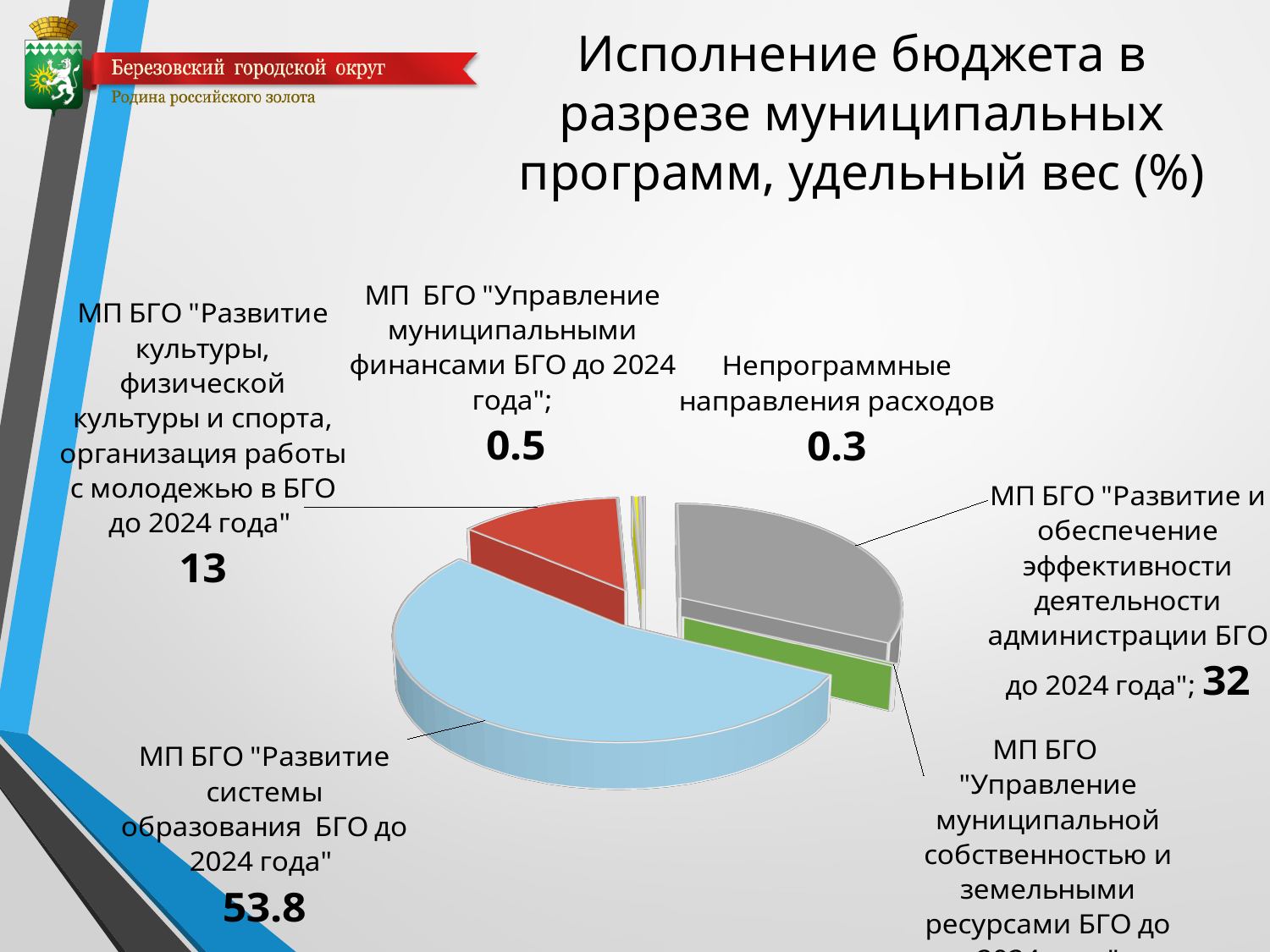
Which is larger: the value for МП БГО "Развитие культуры, физической культуры и спорта..." or the value for МП БГО "Управление муниципальными финансами БГО до 2024 года"? МП БГО "Развитие культуры, физической культуры и спорта..." What type of chart is shown on the slide? pie chart Which of the labelled categories has the smallest printed value? Непрограммные направления расходов What is the title of the chart on the slide? Исполнение бюджета в разрезе муниципальных программ, удельный вес (%) What is the value for МП БГО "Развитие системы образования БГО до 2024 года"? 53.8 What is the value for МП БГО "Управление муниципальными финансами БГО до 2024 года"? 0.5 What is the difference between the values for МП БГО "Развитие системы образования БГО до 2024 года" and МП БГО "Развитие и обеспечение эффективности деятельности администрации БГО до 2024 года"? 21.8 What is the value for МП БГО "Развитие и обеспечение эффективности деятельности администрации БГО до 2024 года"? 32 How many slices does the pie chart have? 6 Which program has the largest share of the pie? МП БГО "Развитие системы образования БГО до 2024 года" What is the value for МП БГО "Развитие культуры, физической культуры и спорта, организация работы с молодежью в БГО до 2024 года"? 13 What is the value for Непрограммные направления расходов? 0.3